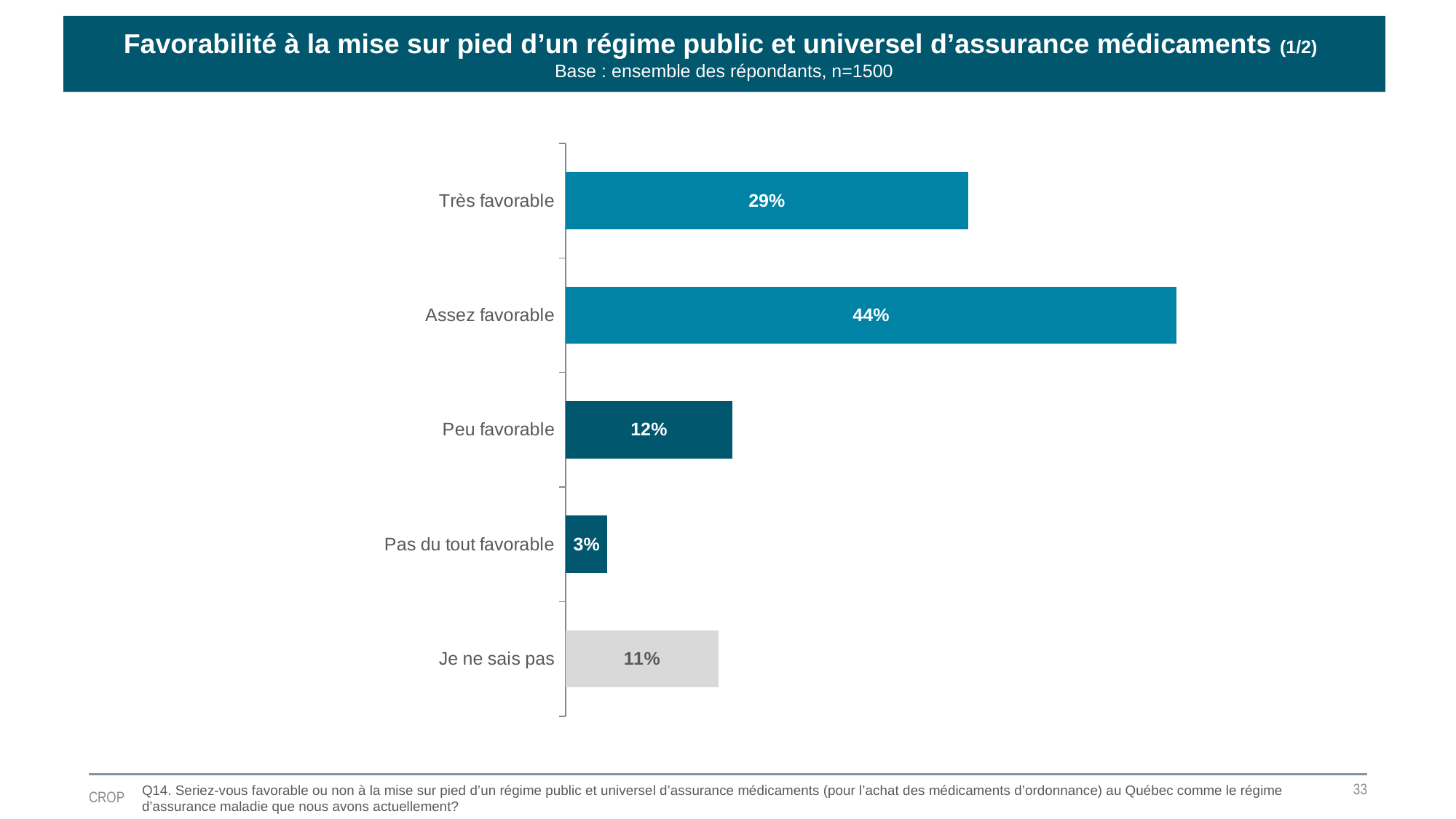
What is the difference between the values for "Assez favorable" and "Très favorable"? 15% What is the value for "Peu favorable"? 12% What is the base (n) stated in the chart title? n=1500 What kind of chart is shown on the slide? Bar chart What is the value for "Très favorable"? 29% Which category has the highest value? Assez favorable Which is larger, the value for "Peu favorable" or the value for "Je ne sais pas"? Peu favorable Which category has the lowest value? Pas du tout favorable What is the value for "Assez favorable"? 44% How many categories are shown in the chart? 5 What is the value for "Pas du tout favorable"? 3% What is the value for "Je ne sais pas"? 11%